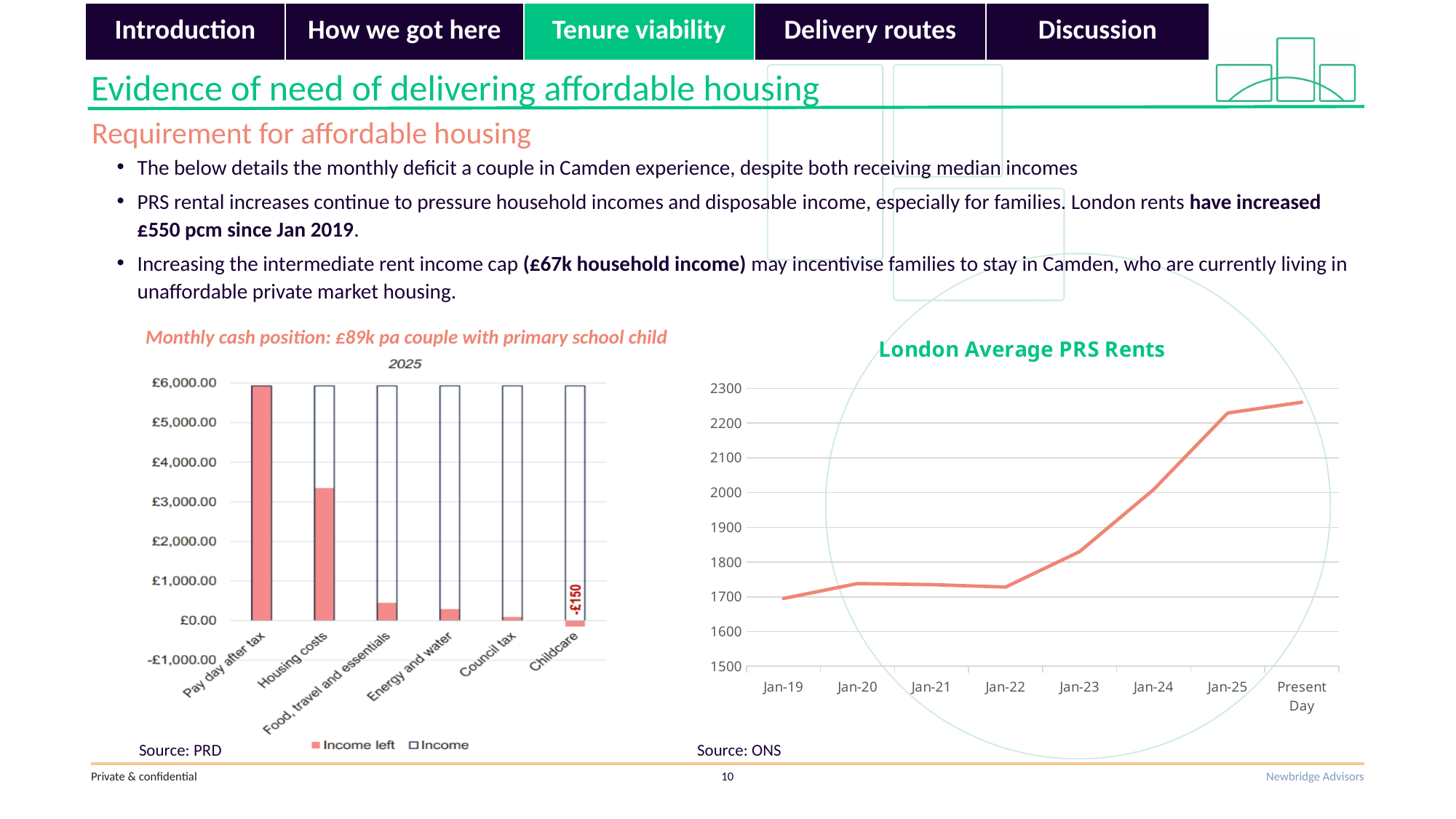
In the 'Monthly cash position' chart, which category has the highest Income left value? Pay day after tax What kind of chart is the 'Monthly cash position' chart on the left? bar chart In the 'London Average PRS Rents' chart, is the value for Present Day greater or less than 2200? greater In the 'London Average PRS Rents' chart, is the value for Jan-19 greater or less than 1800? less What kind of chart is the 'London Average PRS Rents' chart on the right? line chart In the 'London Average PRS Rents' chart, how many points are plotted along the x axis? 8 In the 'Monthly cash position' chart, how many categories are shown on the x axis? 6 In the 'Monthly cash position' chart, how many series does the legend list? 2 In the 'Monthly cash position' chart, what is the Income left value labelled for Childcare? -£150 In the 'London Average PRS Rents' chart, do the values generally rise or fall from Jan-19 to Present Day? rise In the 'London Average PRS Rents' chart, which is larger, the value for Jan-25 or the value for Jan-22? Jan-25 In the 'Monthly cash position' chart, which category has the lowest Income left value? Childcare